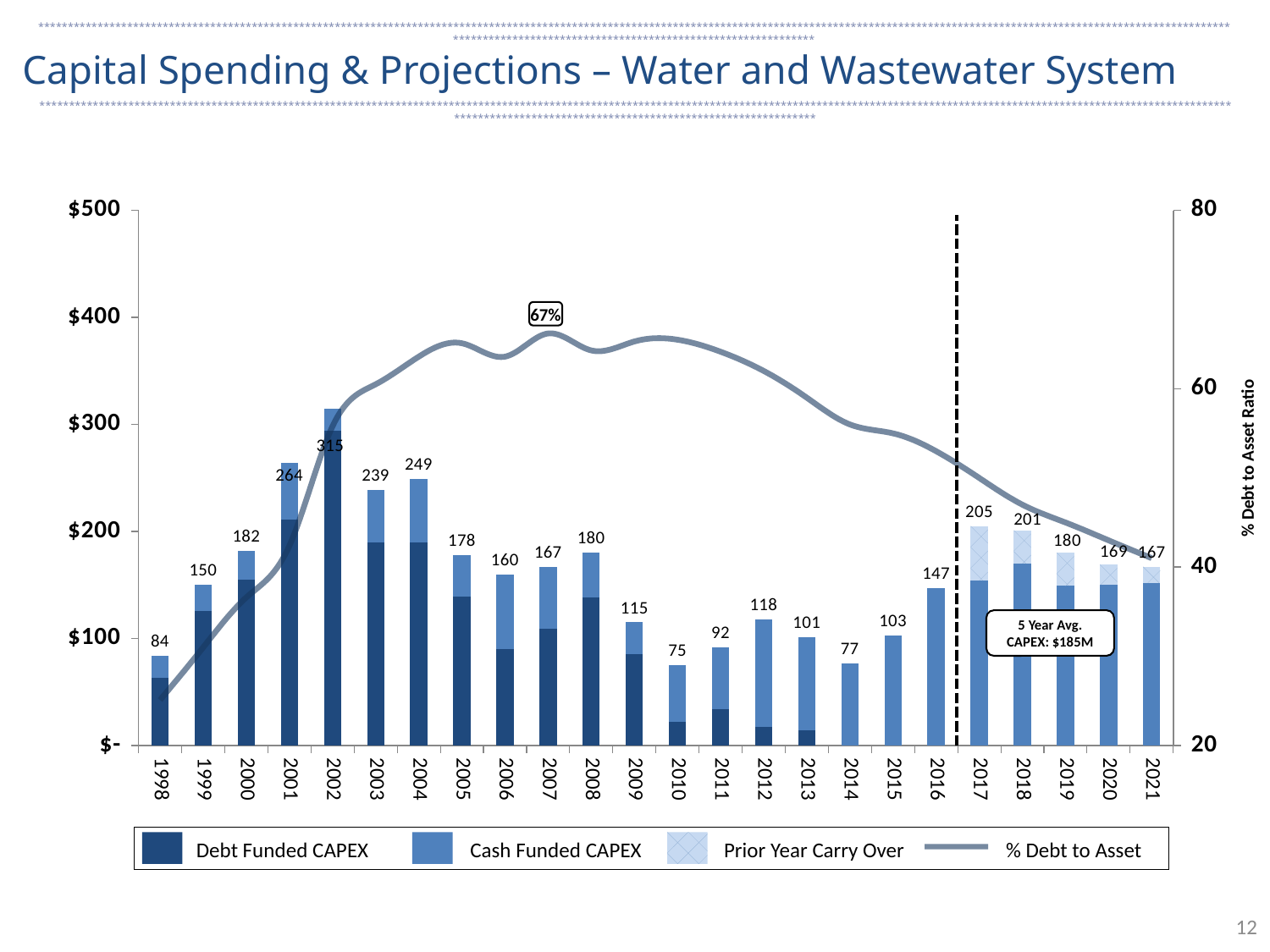
Does the % Debt to Asset line rise or fall from 2007 to 2021? Fall How many years are shown on the x axis? 24 Which year has a larger labeled total, 2017 or 2018? 2017 What is the peak % Debt to Asset value labeled on the line? 67% What is the total capital spending value labeled for 2002? 315 Which year has the lowest total bar value? 2010 What is the total value labeled above the bar for 2016? 147 Which year has the highest total bar value? 2002 Is the % Debt to Asset value for 2016 greater or less than 60? less What is the difference between the labeled totals for 2002 and 2001? 51 What kind of chart is shown on the slide? Combined stacked bar chart and line chart How many series does the legend list? 4